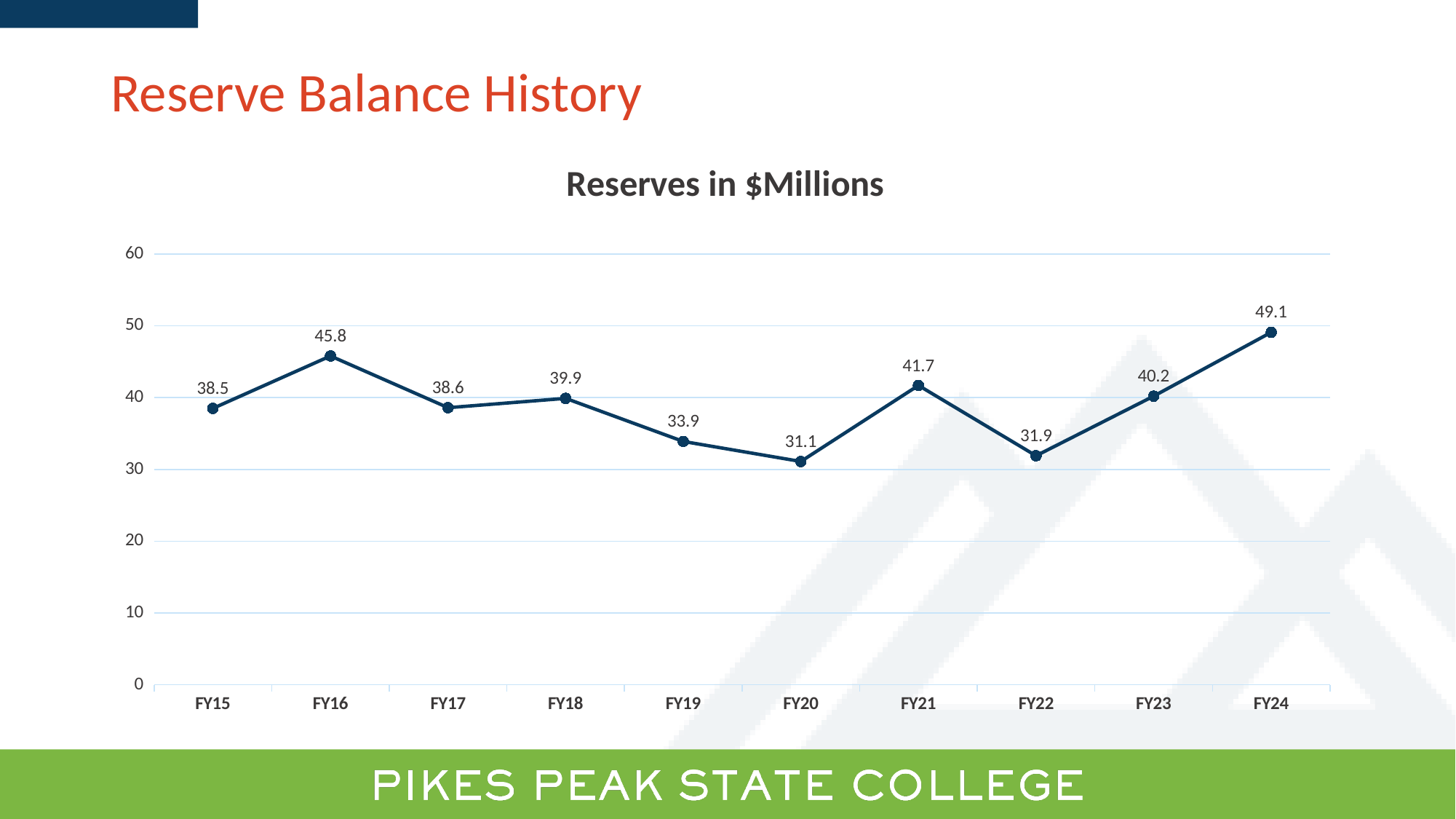
What is the difference between the reserve balance in FY24 and FY15? 10.6 Which is larger, the reserve balance in FY18 or FY19? FY18 What kind of chart is shown on the slide? line chart How many fiscal years are plotted on the chart? 10 Which fiscal year has the lowest reserve balance? FY20 What is the reserve balance for FY20? 31.1 Which fiscal year has the highest reserve balance? FY24 What is the reserve balance for FY23? 40.2 What is the title of the chart? Reserves in $Millions What is the reserve balance for FY16? 45.8 What is the difference between the reserve balance in FY21 and FY22? 9.8 Is the value for FY22 greater or less than 40? less